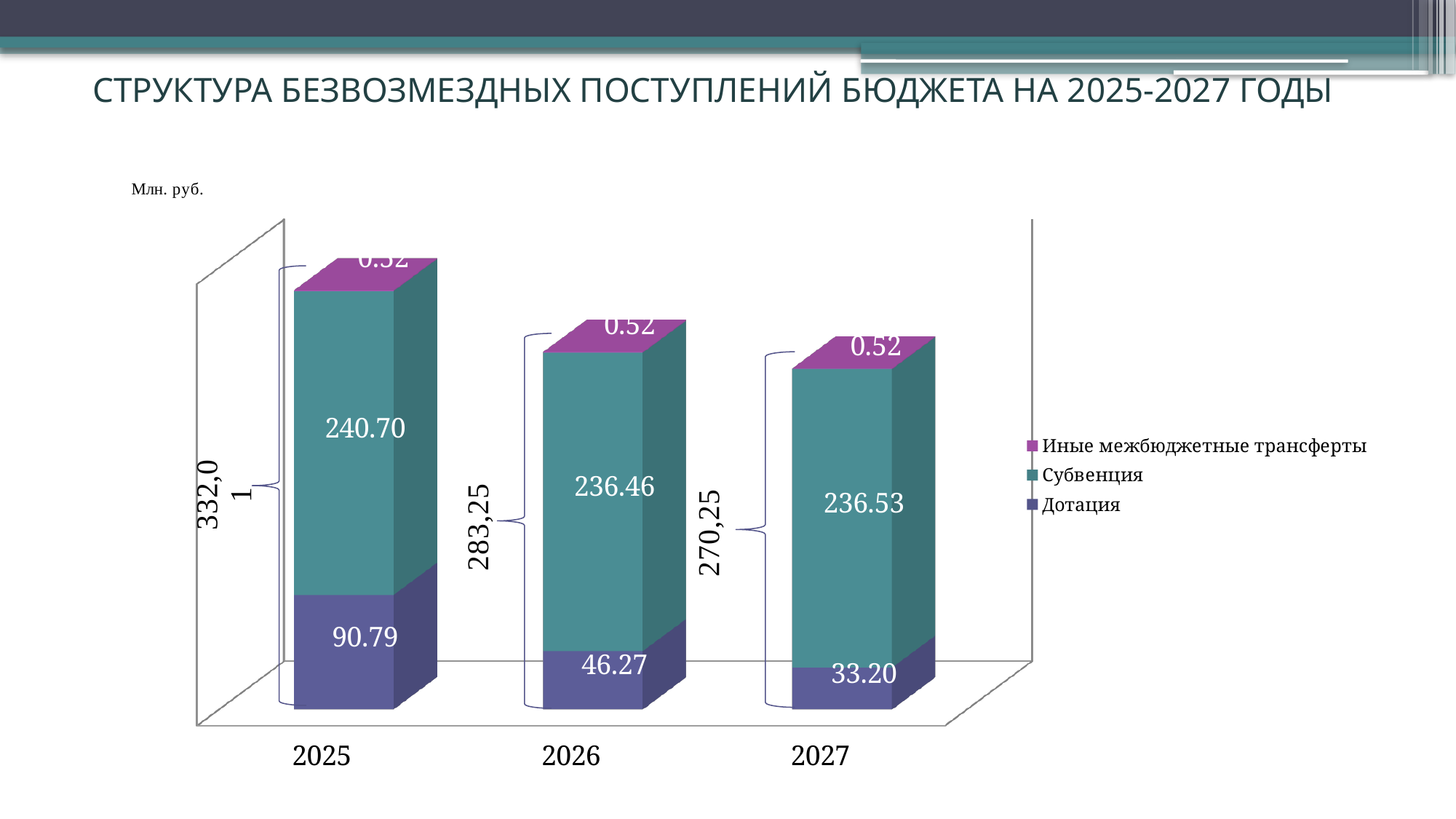
How many series does the legend list? 3 How many years (categories) are shown on the x axis? 3 Does the Дотация value rise or fall from 2025 to 2027? fall What is the total of the stacked bar for 2026, as labelled on the slide? 283,25 What is the value of Субвенция for 2026? 236.46 Which year has the highest value for Дотация? 2025 What is the value of Иные межбюджетные трансферты for 2027? 0.52 What type of chart is shown on the slide? stacked bar chart What is the value of Дотация for 2025? 90.79 Which year has the lowest value for Дотация? 2027 What is the difference between the Дотация values for 2025 and 2026? 44.52 What is the value of Дотация for 2027? 33.20